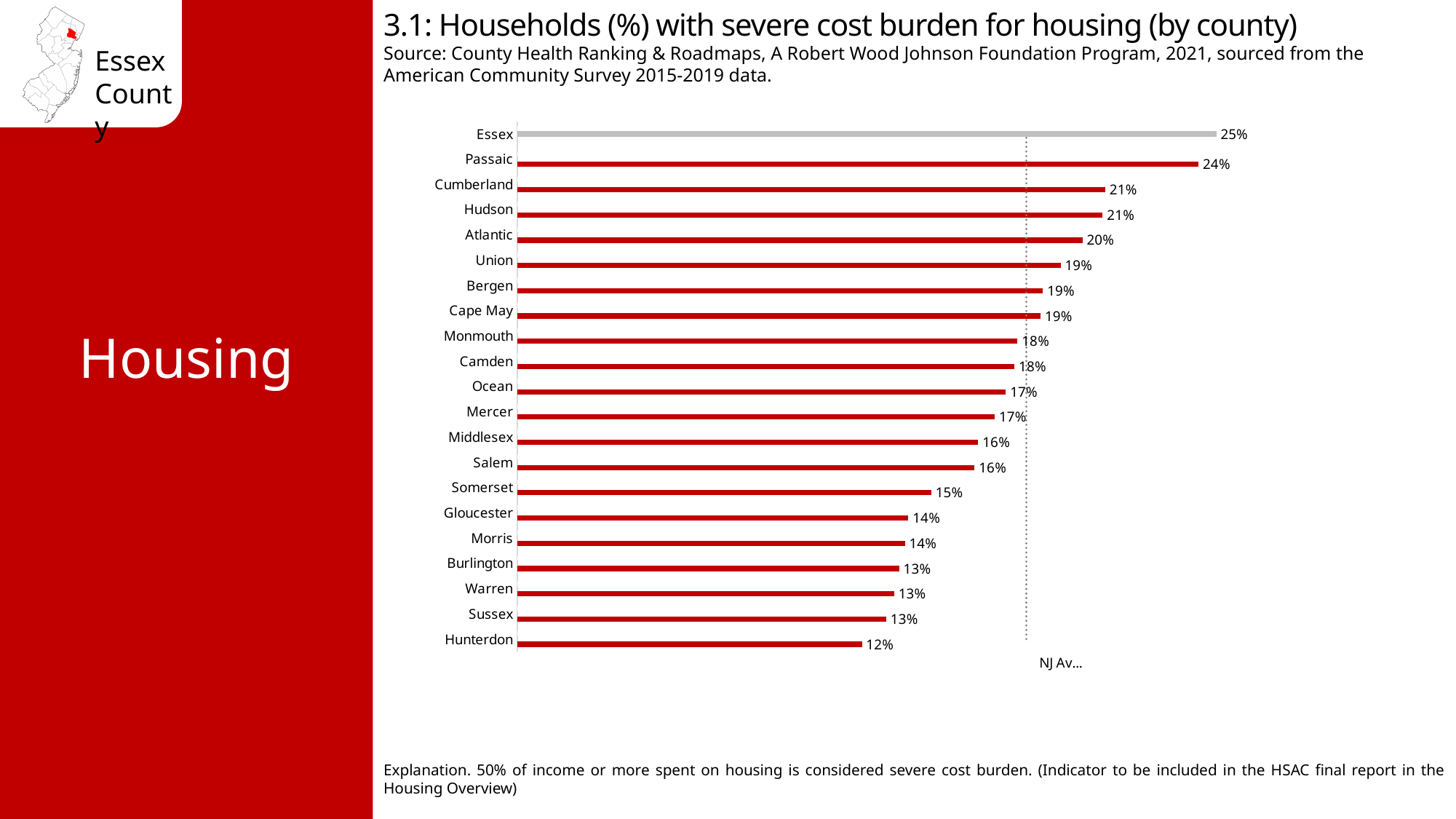
Which county has the highest percentage of households with severe housing cost burden? Essex What is the value shown for Hunterdon County? 12% What is the value shown for Passaic County? 24% Which county has a higher value, Cumberland or Middlesex? Cumberland What is the value shown for Somerset County? 15% What percentage of households in Essex County have a severe cost burden for housing? 25% Which county has the lowest percentage of households with severe housing cost burden? Hunterdon How many counties are shown in the chart? 21 Which county's bar is coloured grey instead of red? Essex What is the difference in percentage points between Essex and Hunterdon? 13 What is the difference in percentage points between Passaic and Atlantic? 4 What type of chart is used on this slide? Bar chart